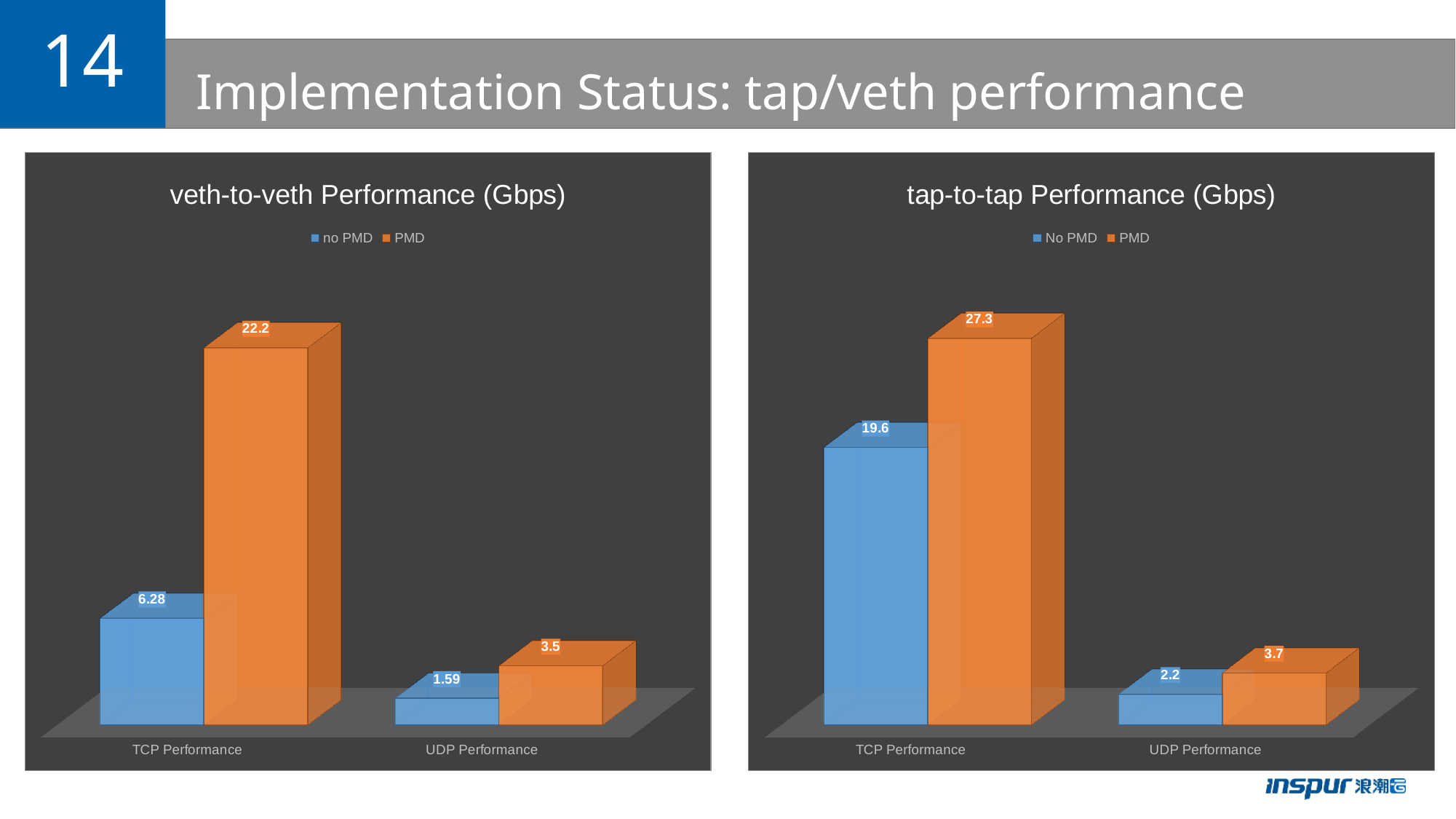
In the veth-to-veth Performance (Gbps) chart, which bar has the highest value? PMD, TCP Performance In the tap-to-tap Performance (Gbps) chart, which bar has the lowest value? No PMD, UDP Performance In the veth-to-veth Performance (Gbps) chart, what is the PMD value for TCP Performance? 22.2 How many series does the legend of the tap-to-tap Performance (Gbps) chart list? 2 In the tap-to-tap Performance (Gbps) chart, what is the difference between the PMD and No PMD values for TCP Performance? 7.7 In the veth-to-veth Performance (Gbps) chart, what is the difference between the PMD and no PMD values for TCP Performance? 15.92 In the tap-to-tap Performance (Gbps) chart, what is the PMD value for UDP Performance? 3.7 What kind of chart is the tap-to-tap Performance (Gbps) chart? Bar chart In the veth-to-veth Performance (Gbps) chart, which is larger for UDP Performance: no PMD or PMD? PMD In the veth-to-veth Performance (Gbps) chart, what is the no PMD value for UDP Performance? 1.59 In the tap-to-tap Performance (Gbps) chart, what is the No PMD value for TCP Performance? 19.6 How many categories are shown on the x axis of the veth-to-veth Performance (Gbps) chart? 2